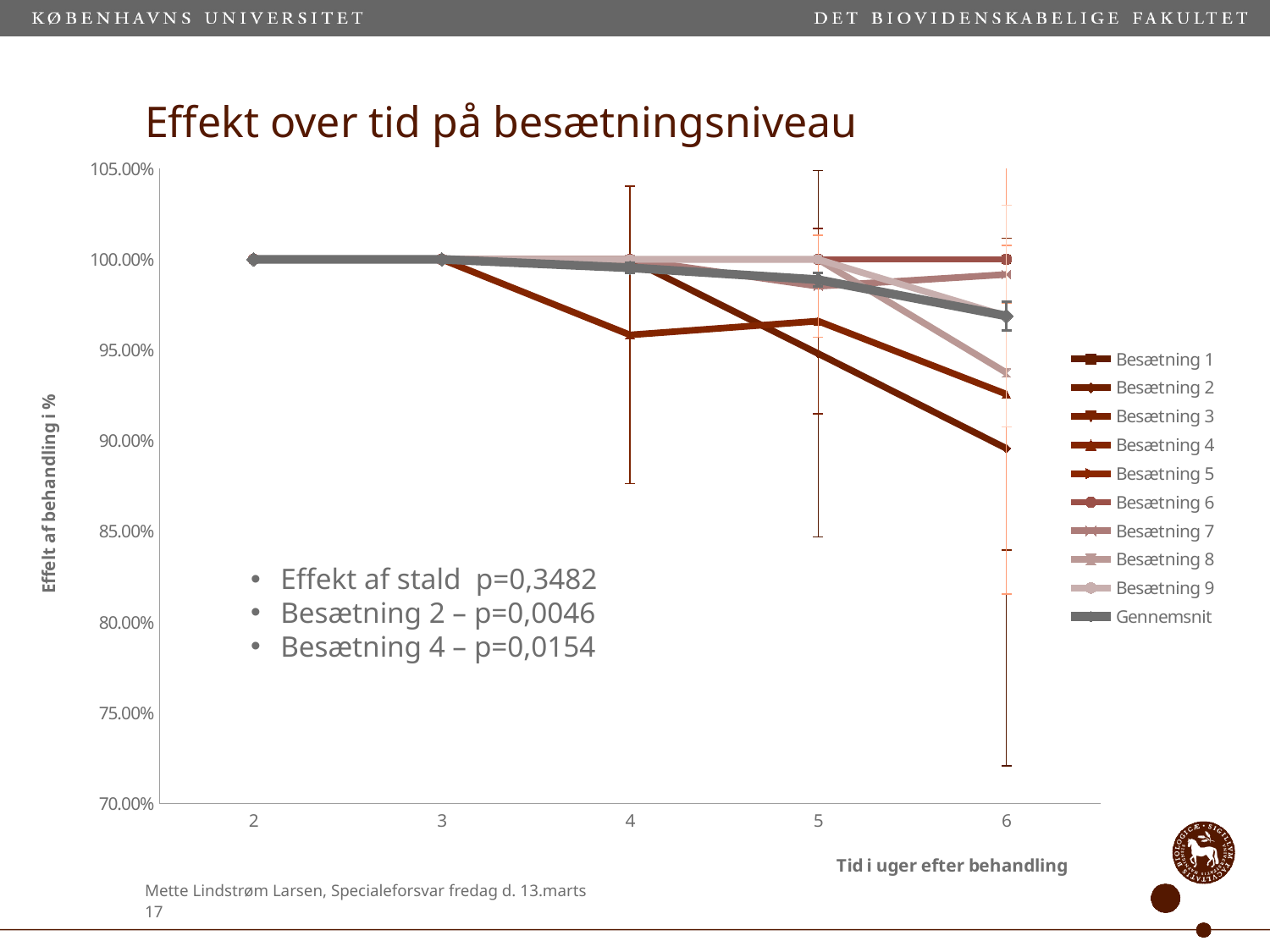
Which series has the lowest value at week 6? Besætning 2 Does the Gennemsnit line rise or fall from week 2 to week 6? fall What is the title of the x axis? Tid i uger efter behandling What is the title of the chart? Effekt over tid på besætningsniveau How many time points are shown on the x axis? 5 What kind of chart is shown on the slide? line chart Is the value for Gennemsnit at week 6 greater or less than 95.00%? greater Is the value for Besætning 2 at week 6 greater or less than 95.00%? less What is the value for Gennemsnit at week 2? 100.00% How many series does the legend list? 10 Is the value for Besætning 4 at week 6 greater or less than 95.00%? less At week 6, which is larger: the value for Gennemsnit or the value for Besætning 2? Gennemsnit